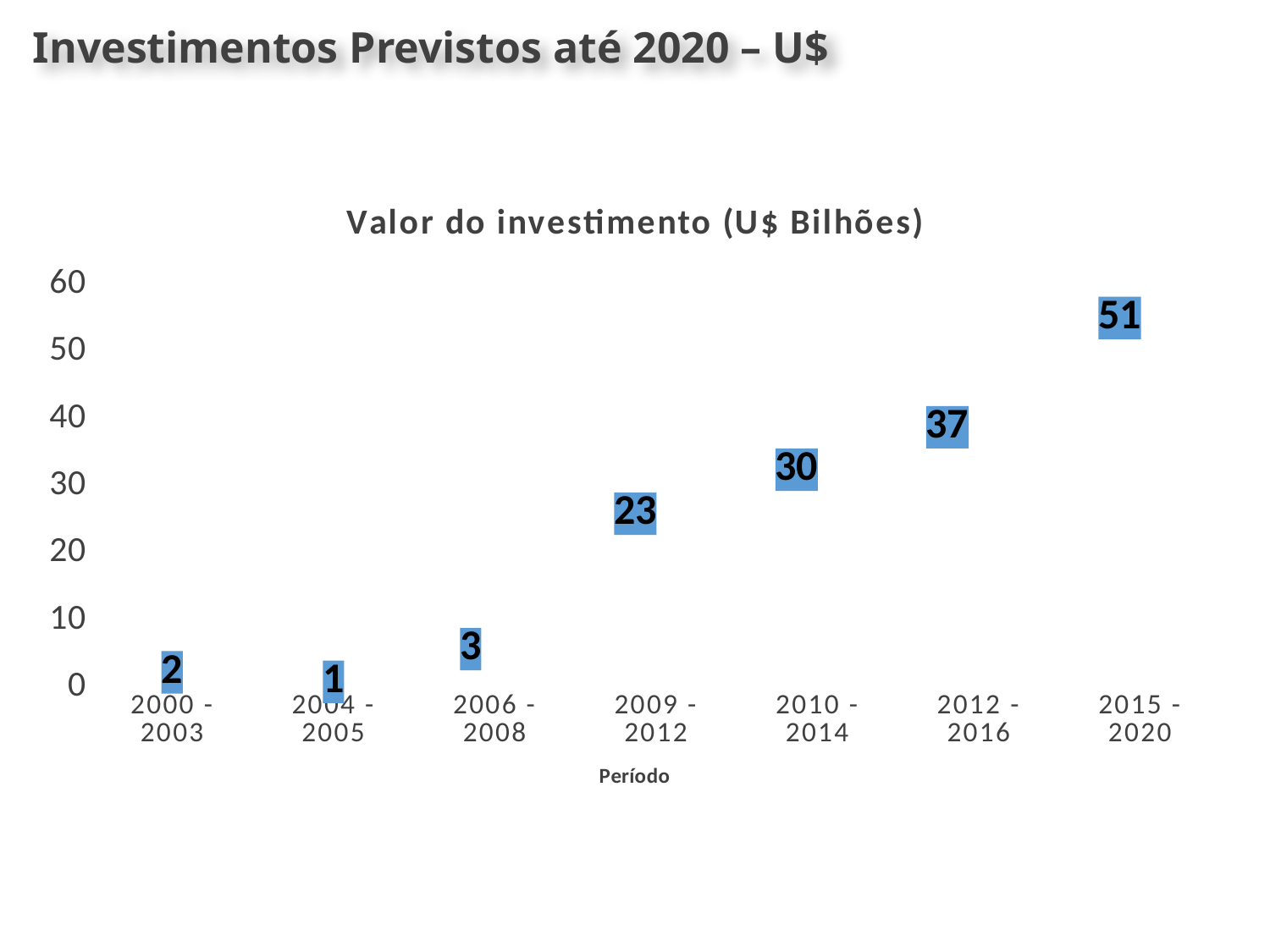
Which period has the lowest value? 2004 - 2005 Which period has the highest value? 2015 - 2020 Is the value for 2012 - 2016 greater or less than 40? less What is the difference between the values for 2015 - 2020 and 2012 - 2016? 14 What is the title of the chart? Valor do investimento (U$ Bilhões) What is the value for the period 2015 - 2020? 51 Do the values generally rise or fall from the 2006 - 2008 period to the 2015 - 2020 period? rise What is the value for the period 2009 - 2012? 23 What is the difference between the values for 2010 - 2014 and 2009 - 2012? 7 How many periods are shown on the x axis? 7 What is the value for the period 2004 - 2005? 1 Which is larger, the value for 2006 - 2008 or the value for 2000 - 2003? 2006 - 2008